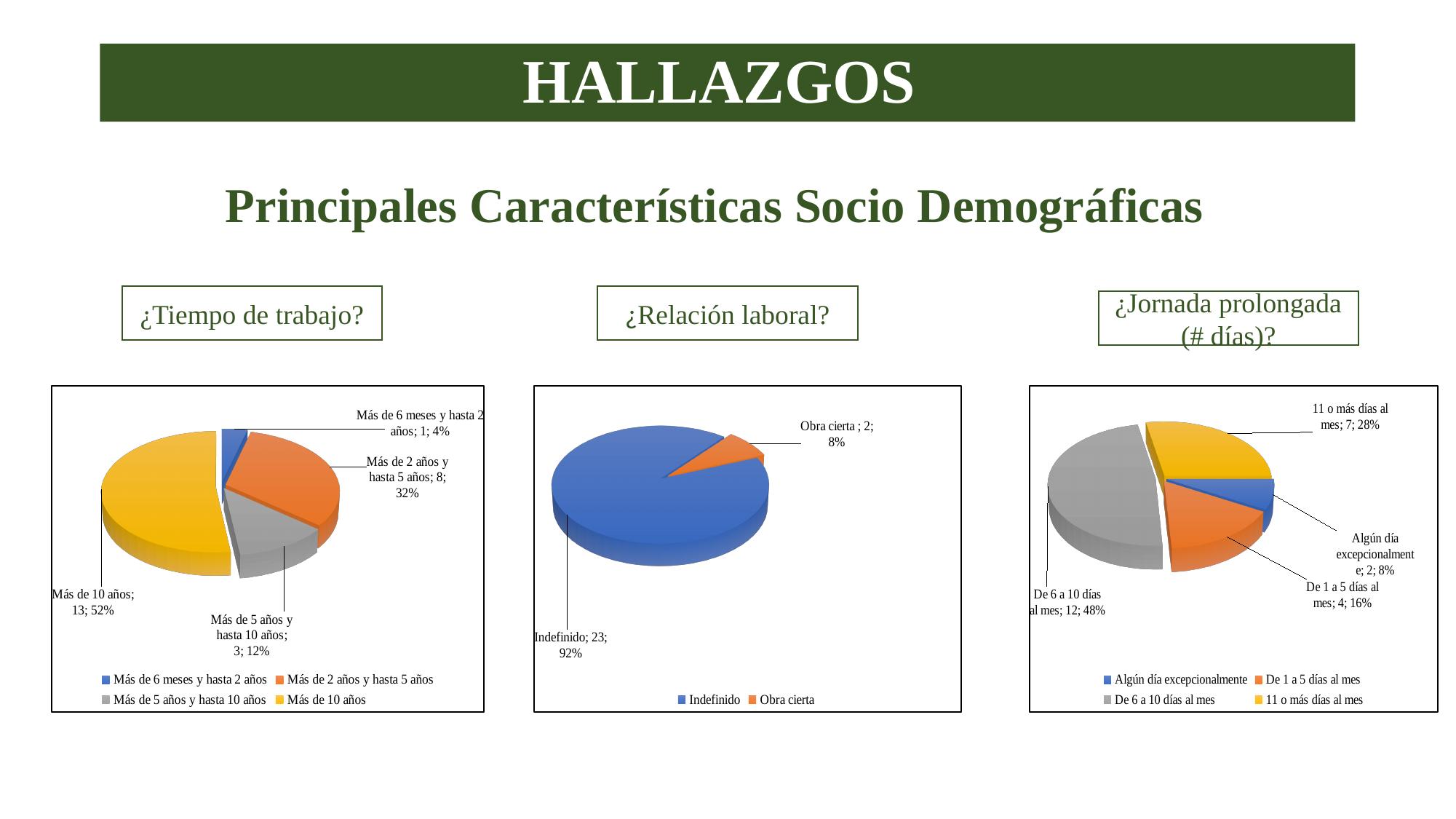
In the '¿Jornada prolongada (# días)?' pie chart, which is larger: '11 o más días al mes' or 'Algún día excepcionalmente'? 11 o más días al mes What kind of chart is the '¿Relación laboral?' chart? Pie chart In the '¿Tiempo de trabajo?' pie chart, what is the value for 'Más de 10 años'? 13 In the '¿Tiempo de trabajo?' pie chart, what share of the pie is 'Más de 2 años y hasta 5 años'? 32% In the '¿Jornada prolongada (# días)?' pie chart, what colour is the 'De 6 a 10 días al mes' slice? Grey In the '¿Jornada prolongada (# días)?' pie chart, which category has the largest value? De 6 a 10 días al mes In the '¿Relación laboral?' pie chart, what is the value for 'Indefinido'? 23 In the '¿Jornada prolongada (# días)?' pie chart, what is the value for 'De 1 a 5 días al mes'? 4 In the '¿Tiempo de trabajo?' pie chart, what is the difference between 'Más de 10 años' and 'Más de 5 años y hasta 10 años'? 10 In the '¿Tiempo de trabajo?' pie chart, how many categories are shown? 4 In the '¿Relación laboral?' pie chart, what share of the pie is 'Obra cierta'? 8% In the '¿Tiempo de trabajo?' pie chart, which category has the smallest value? Más de 6 meses y hasta 2 años